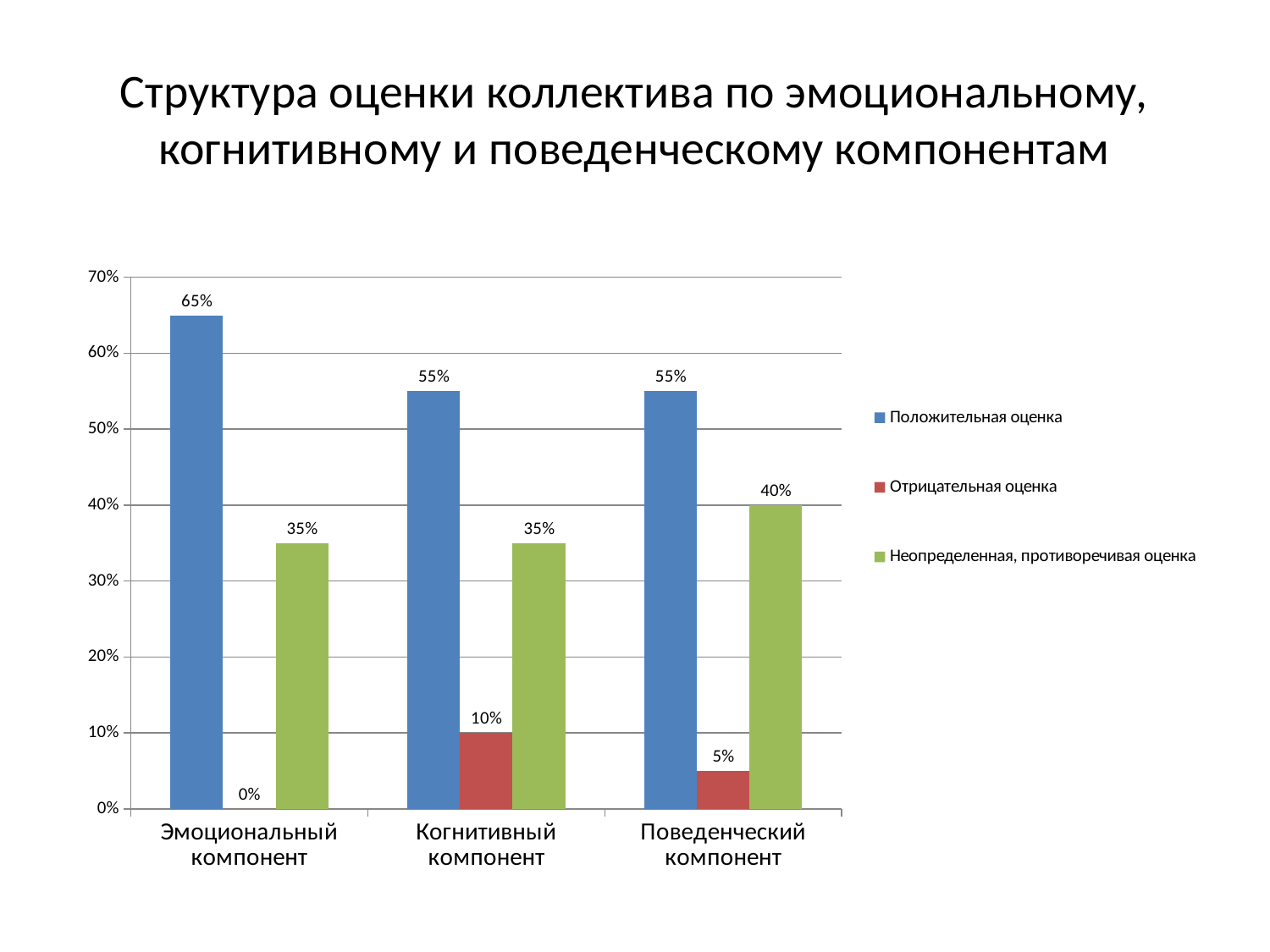
Which colour represents Отрицательная оценка in the legend? Red What is the value of Положительная оценка for Эмоциональный компонент? 65% What is the value of Неопределенная, противоречивая оценка for Поведенческий компонент? 40% How many series does the legend list? 3 What is the value of Отрицательная оценка for Когнитивный компонент? 10% What is the difference between Положительная оценка and Неопределенная, противоречивая оценка for Поведенческий компонент? 15% Which component has the lowest value for Отрицательная оценка? Эмоциональный компонент What is the value of Отрицательная оценка for Эмоциональный компонент? 0% Which is larger for Когнитивный компонент: Отрицательная оценка or Неопределенная, противоречивая оценка? Неопределенная, противоречивая оценка What kind of chart is shown on the slide? Bar chart Which component has the highest value for Положительная оценка? Эмоциональный компонент How many categories are shown on the x axis? 3